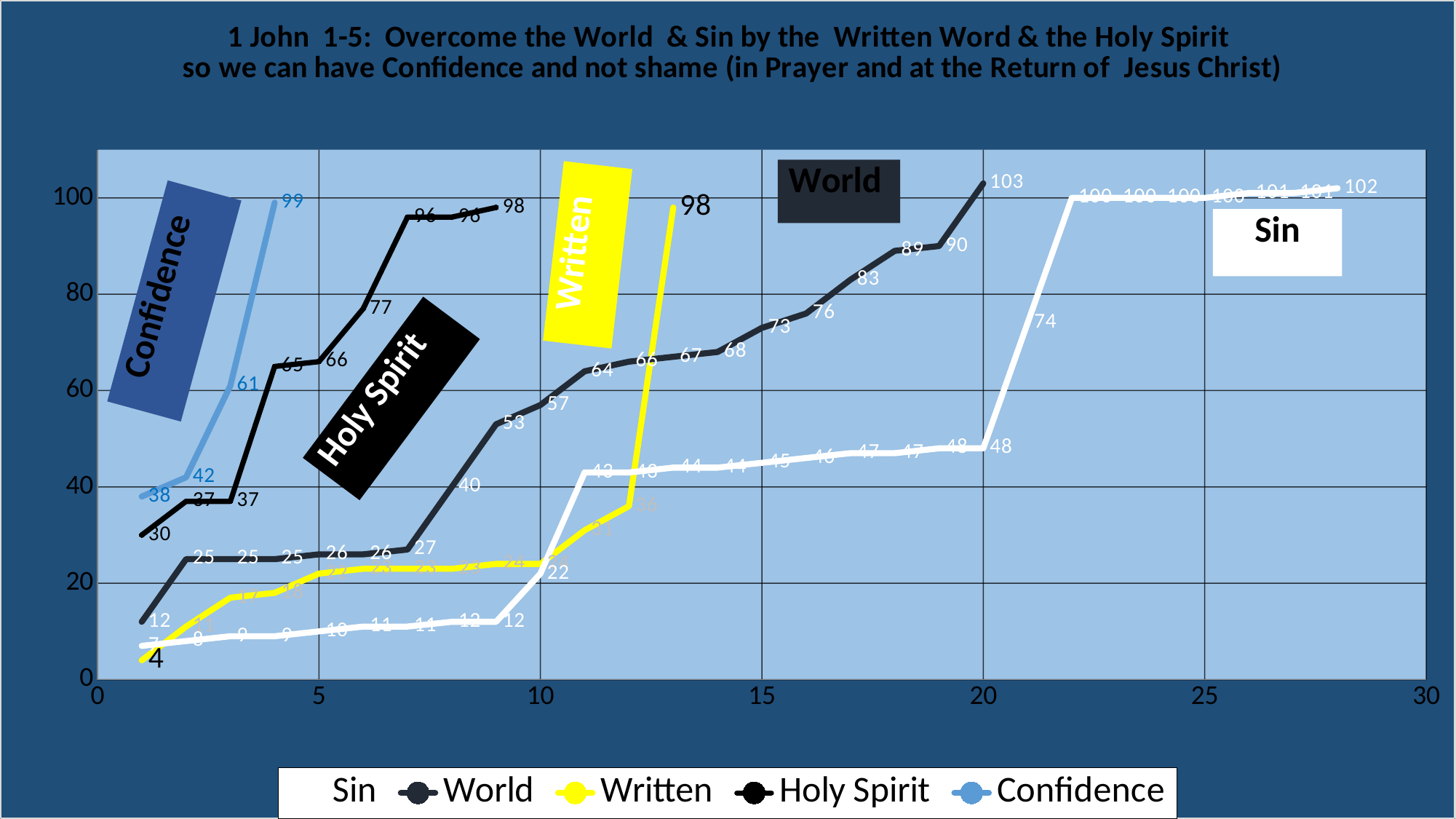
What is the last labelled value of the Confidence series? 99 What is the final labelled value of the Sin series? 102 Which series is drawn in yellow? Written How many series does the legend list? 5 What is the difference between the final value of the World series (103) and the final value of the Holy Spirit series (98)? 5 What is the first labelled value of the Holy Spirit series? 30 Do the values of the Sin series rise or fall along the x axis? rise How many data points does the Confidence series have? 4 What kind of chart is shown on the slide? line chart What is the final labelled value of the Written series? 98 At x = 20, which series has the larger value, World or Sin? World What is the highest value reached by the World series? 103